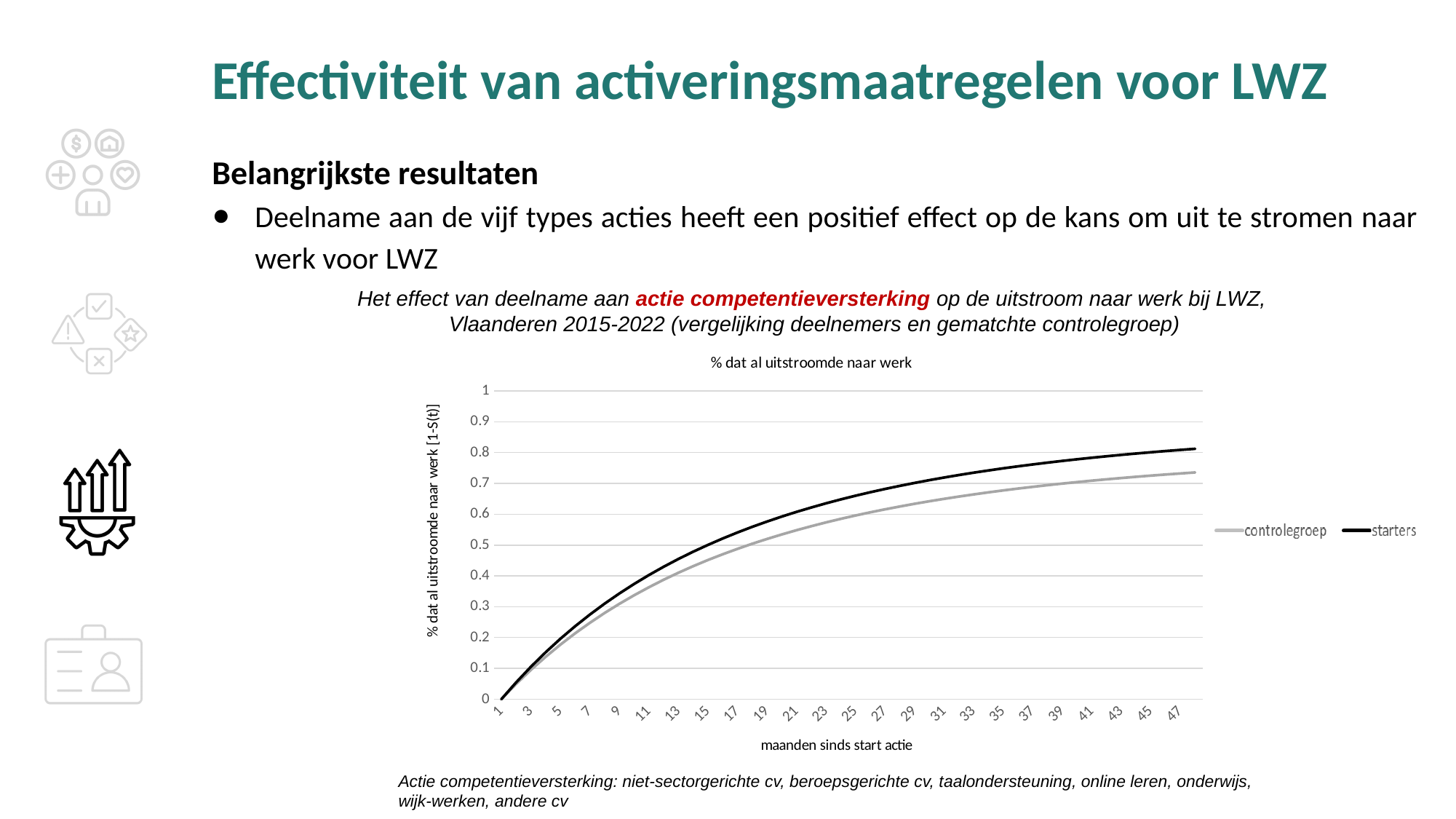
At month 23, which series has the higher value: controlegroep or starters? starters Do the values for the controlegroep series rise or fall along the x axis? rise At month 47, which series has the higher value: starters or controlegroep? starters Is the value for controlegroep at month 47 greater or less than 0.7? greater Which series is drawn in black in the chart? starters What are the two series named in the chart legend? controlegroep and starters How many series does the chart legend list? 2 Is the value for controlegroep at month 47 greater or less than 0.8? less What is the label of the x axis of the chart? maanden sinds start actie Do the values for the starters series rise or fall as the months since the start of the action increase? rise What kind of chart is shown on the slide? line chart Is the value for controlegroep at month 11 greater or less than 0.4? less